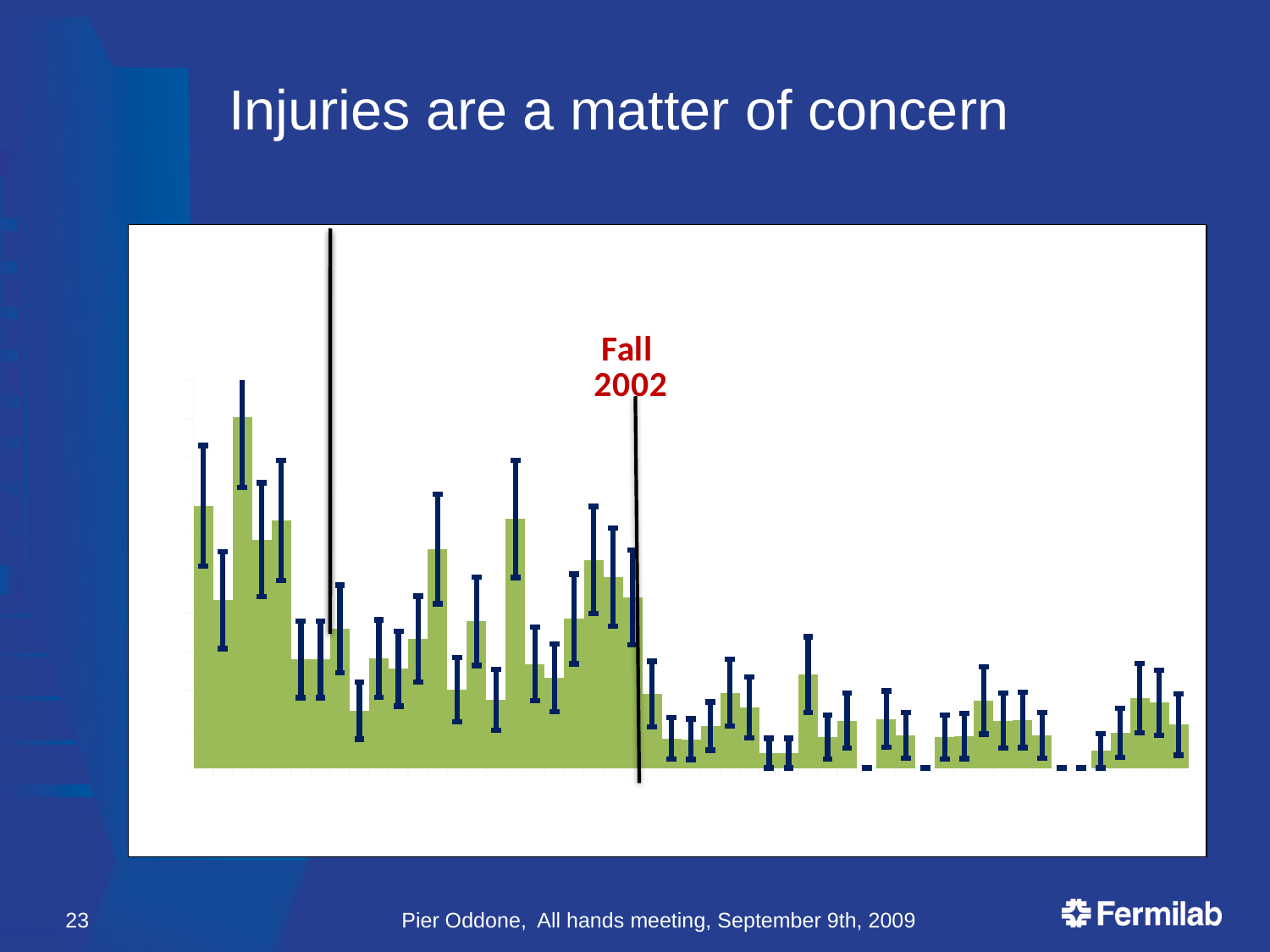
What date label is written in red on the chart? Fall 2002 What colour are the bars in the chart? green What kind of chart is shown on the slide? bar chart Do the bar values generally rise or fall from left to right along the x axis? fall Are the bars to the left of the Fall 2002 marker generally higher or lower than the bars to the right of it? higher